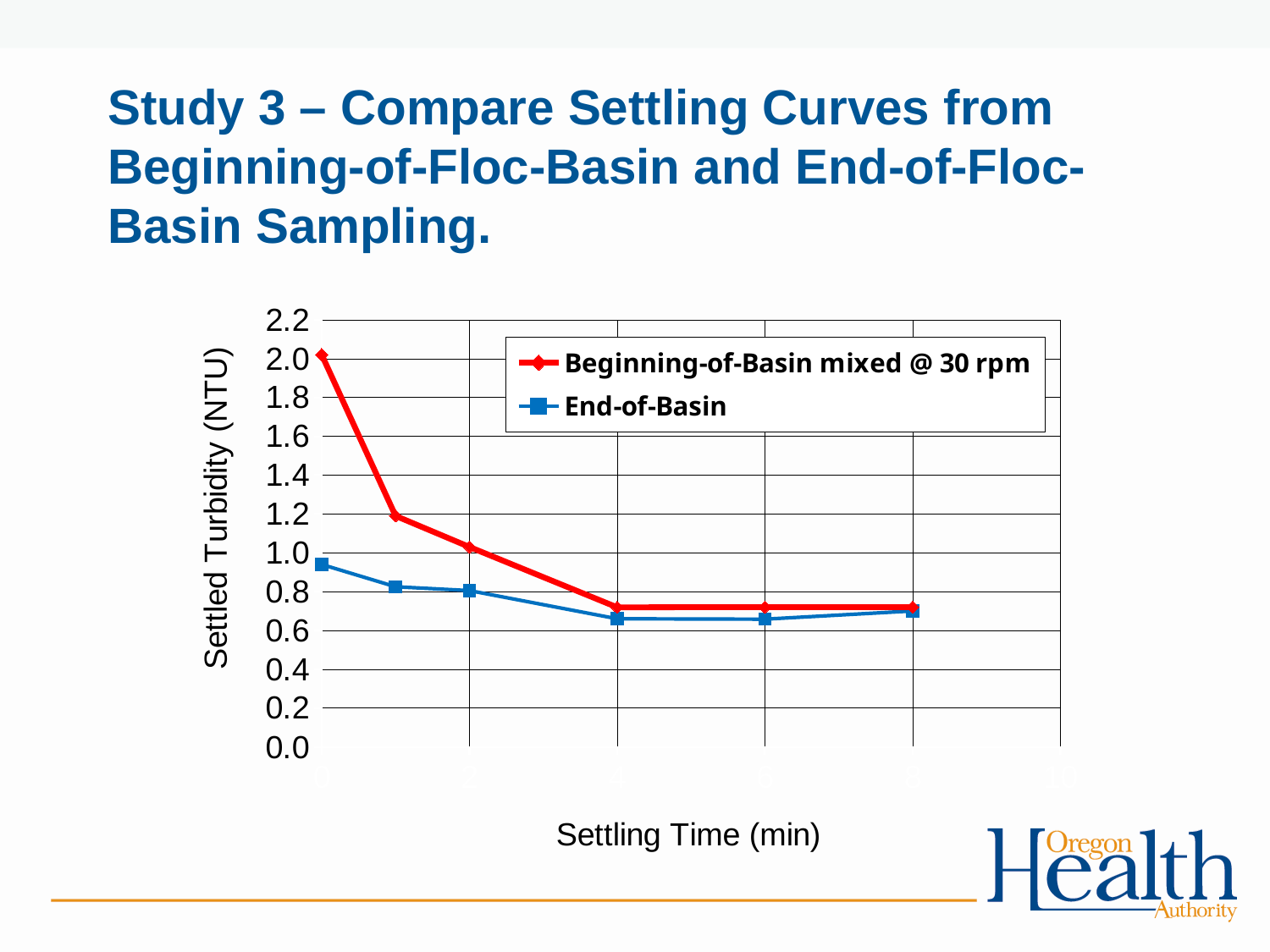
Do the settled turbidity values for the Beginning-of-Basin mixed @ 30 rpm series rise or fall as settling time increases? Fall Is the lowest plotted value of the End-of-Basin series greater or less than 0.8? less How many data points are plotted for the End-of-Basin series? 6 How many data points are plotted for the Beginning-of-Basin mixed @ 30 rpm series? 6 How many series does the chart legend list? 2 Which series has the higher settled turbidity at its first plotted point: Beginning-of-Basin mixed @ 30 rpm or End-of-Basin? Beginning-of-Basin mixed @ 30 rpm Which series reaches the highest settled turbidity value on the chart? Beginning-of-Basin mixed @ 30 rpm Is the first plotted value of the End-of-Basin series greater or less than 1.2? less What are the two series named in the legend? Beginning-of-Basin mixed @ 30 rpm; End-of-Basin What is the title of the vertical axis? Settled Turbidity (NTU) What kind of chart is shown on the slide? Line chart Is the first plotted value of the Beginning-of-Basin mixed @ 30 rpm series greater or less than 1.8? greater